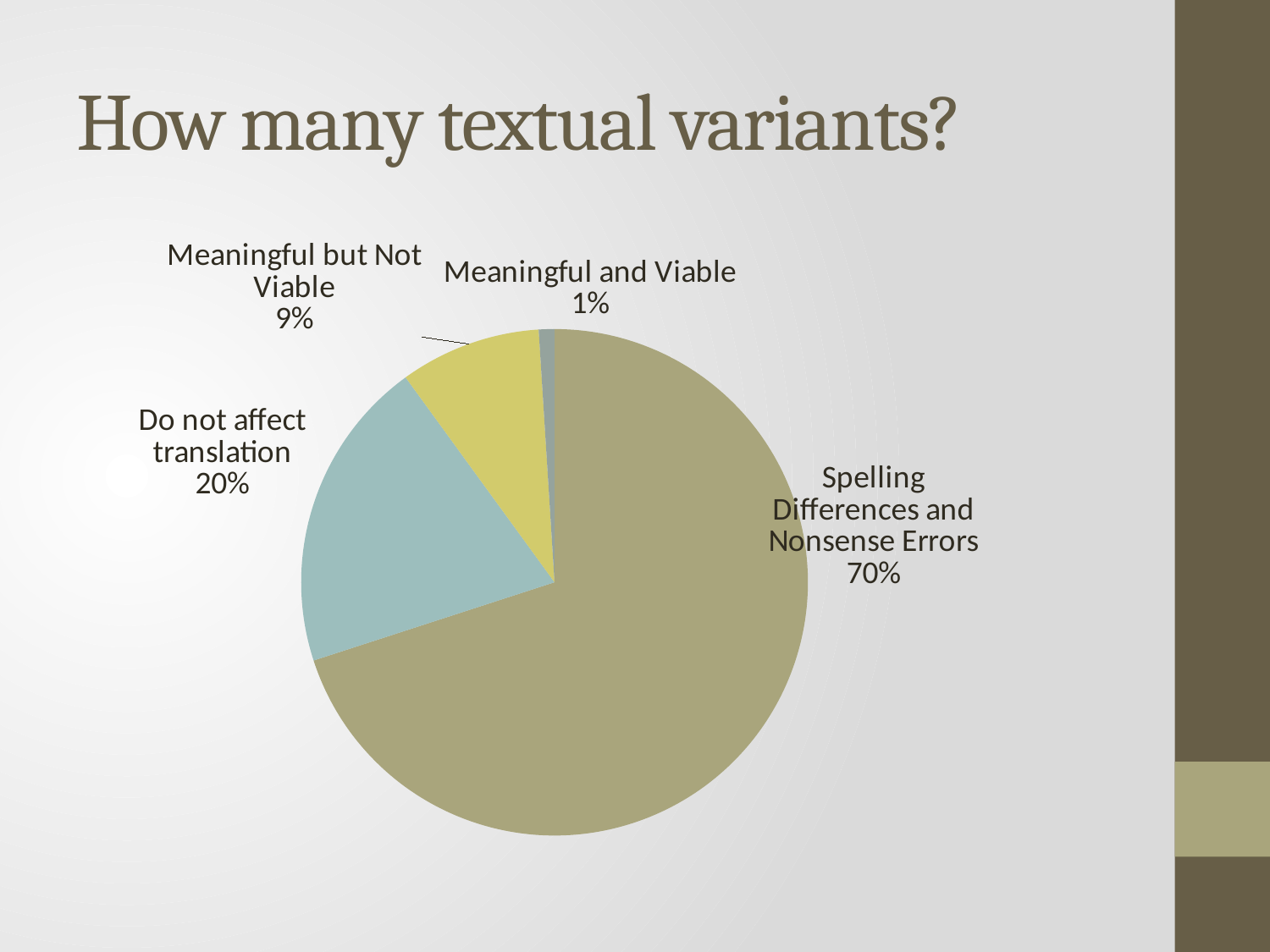
What kind of chart is shown on the slide? pie chart Which category has the largest slice of the pie? Spelling Differences and Nonsense Errors What is the title of the slide containing the pie chart? How many textual variants? What share of the pie is labelled "Spelling Differences and Nonsense Errors"? 70% What share of the pie is labelled "Meaningful and Viable"? 1% Which is larger: the slice for "Do not affect translation" or the slice for "Meaningful but Not Viable"? Do not affect translation Which category has the smallest slice of the pie? Meaningful and Viable How many slices does the pie chart have? 4 What share of the pie is labelled "Do not affect translation"? 20% What is the difference in percentage points between "Spelling Differences and Nonsense Errors" and "Do not affect translation"? 50 What is the difference in percentage points between "Meaningful but Not Viable" and "Meaningful and Viable"? 8